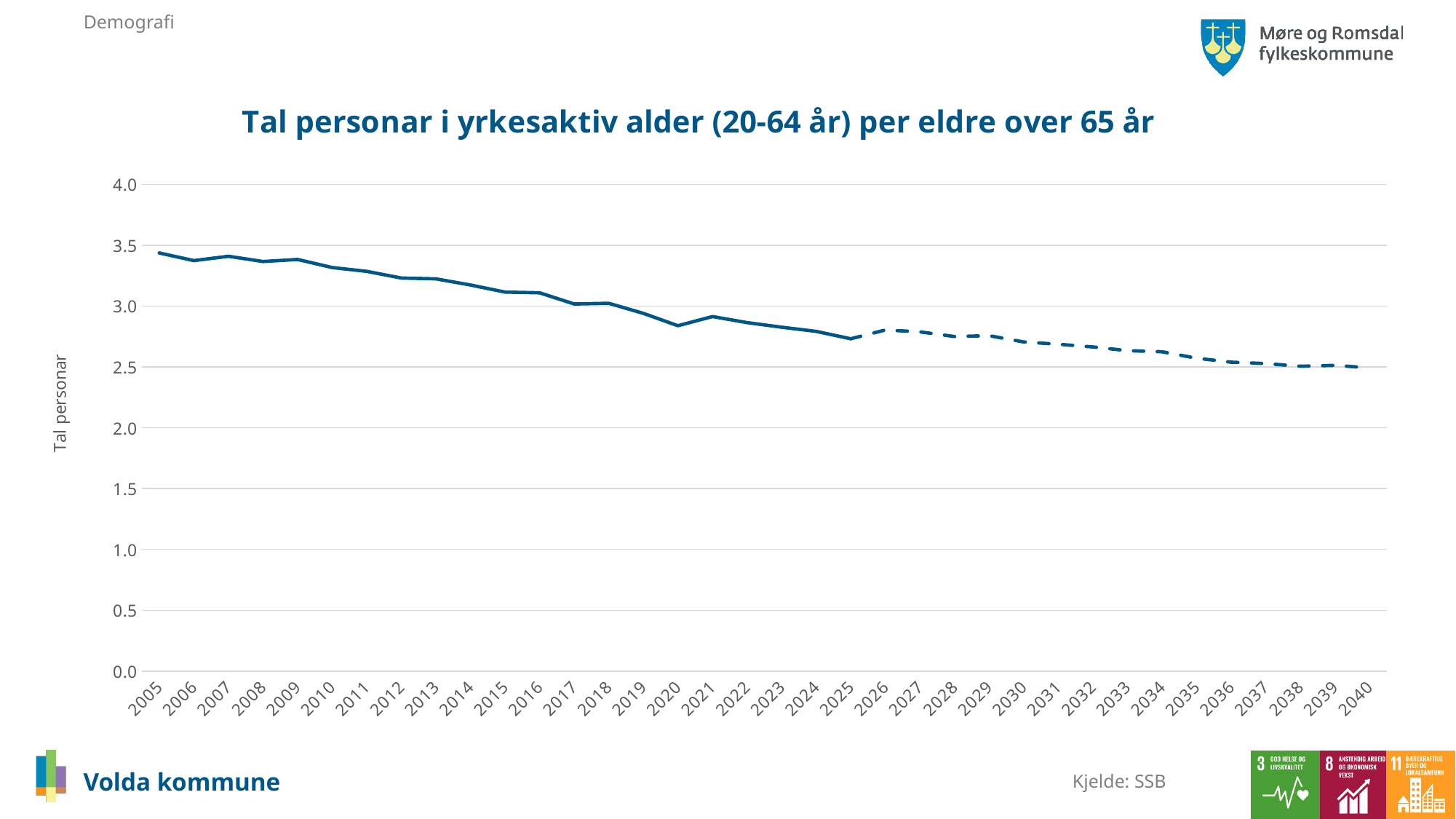
Which year has the larger value, 2010 or 2020? 2010 Is the value for 2040 greater or less than 3.0? less Is the value for 2010 greater or less than 3.0? greater How many years are shown along the x axis of the chart? 36 What is the label on the vertical axis of the chart? Tal personar What is the title of the chart? Tal personar i yrkesaktiv alder (20-64 år) per eldre over 65 år Is the value for 2020 greater or less than 3.0? less Which year has the larger value, 2005 or 2040? 2005 Do the values rise or fall from 2005 to 2040? fall What kind of chart is shown on the slide? line chart